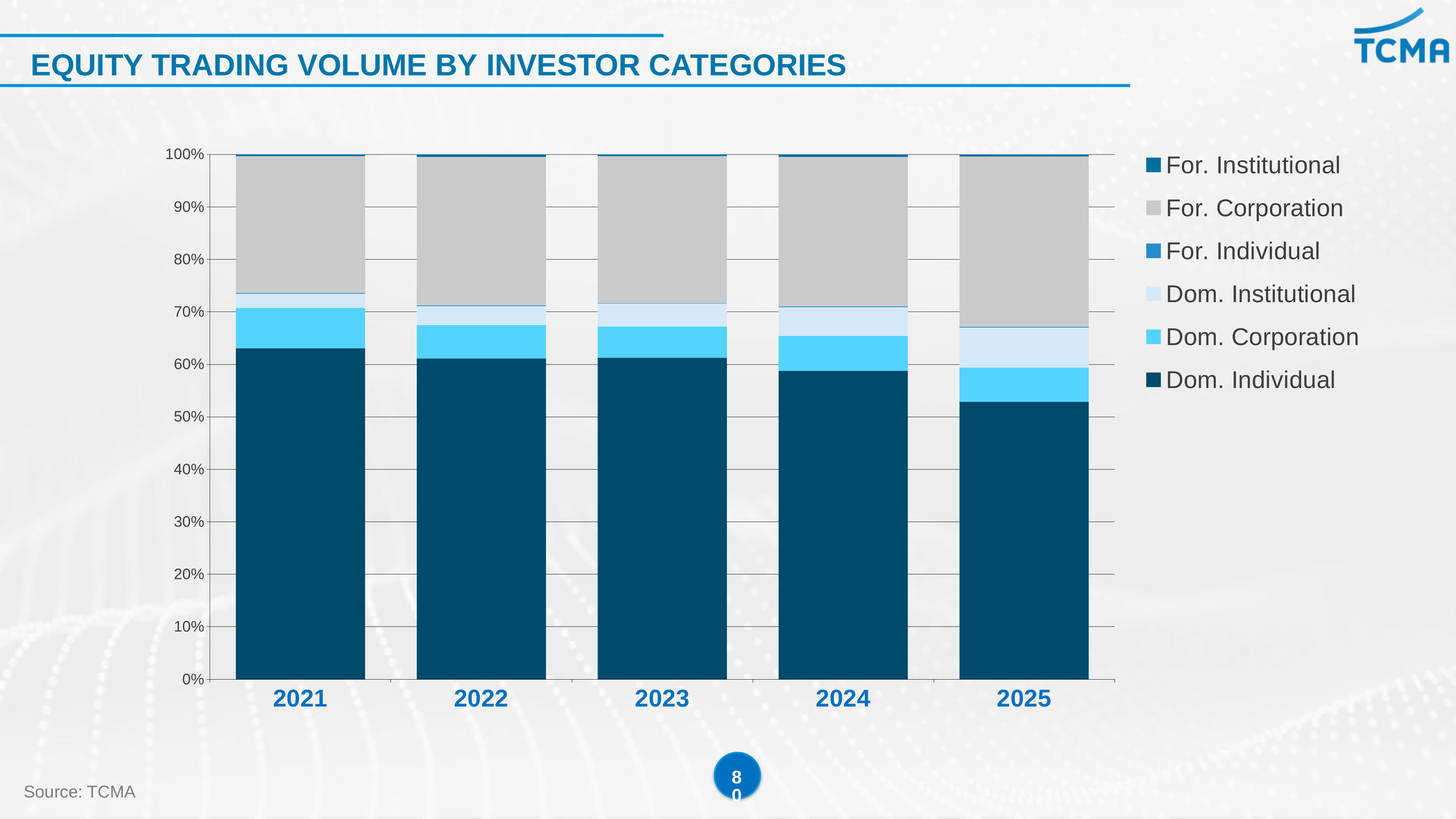
Is the Dom. Individual share in 2021 greater or less than 60%? greater Does the Dom. Individual share rise or fall from 2021 to 2025? fall What kind of chart is shown on the slide? Stacked bar chart What is the title of the chart on the slide? Equity Trading Volume by Investor Categories How many years are shown on the x axis of the chart? 5 How many series does the legend list? 6 Is the Dom. Individual share in 2025 greater or less than 60%? less In which year is the Dom. Individual share the highest? 2021 Is the Dom. Individual share in 2025 greater or less than 50%? greater Which year has the larger For. Corporation share, 2021 or 2025? 2025 In which year is the Dom. Individual share the lowest? 2025 Which series is shown at the bottom of each stacked bar? Dom. Individual